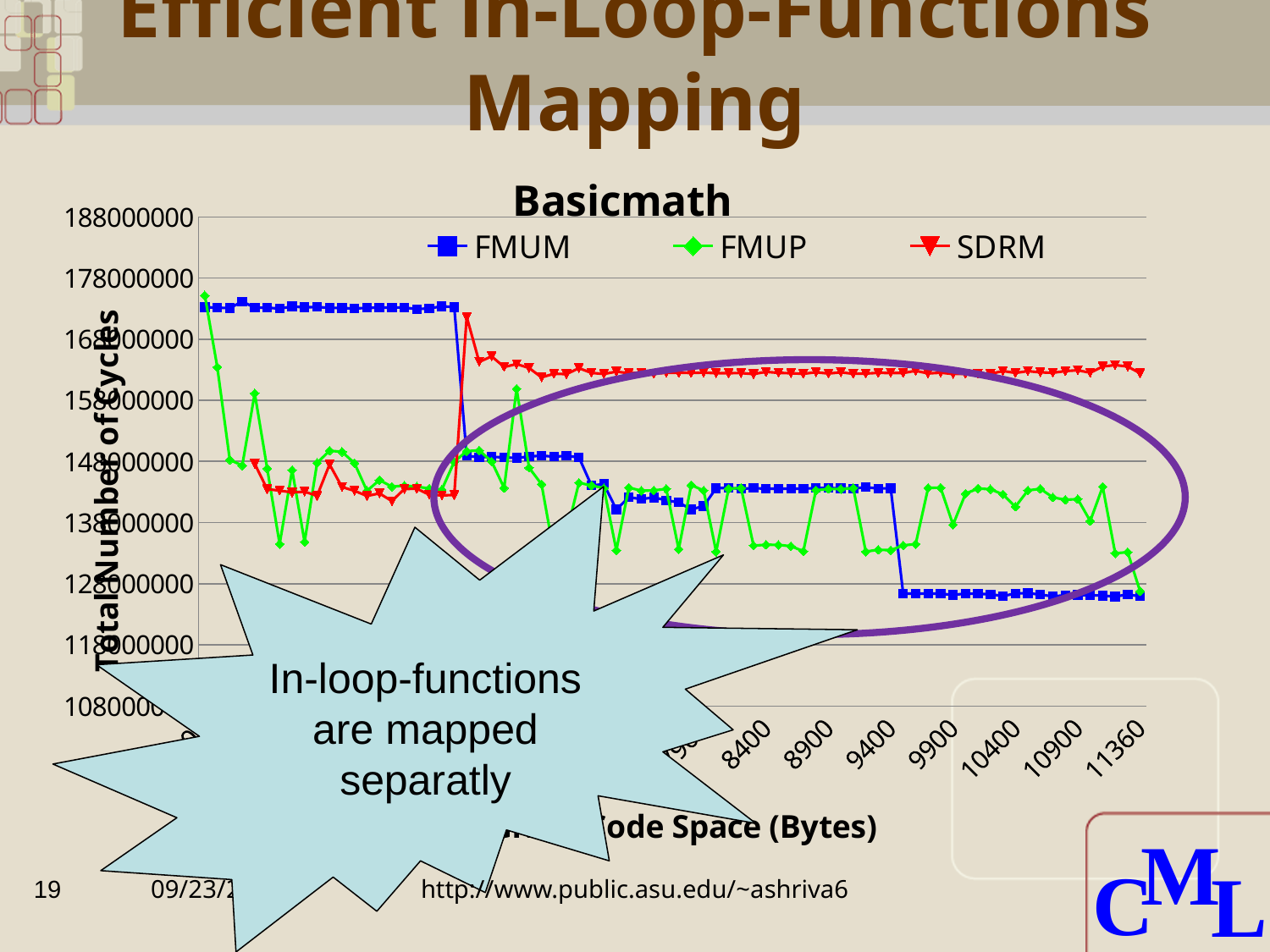
Is the SDRM value at 11360 bytes greater or less than 158000000? greater At 9900 bytes, which series has the larger value, FMUP or FMUM? FMUP Does the FMUM series rise or fall overall as Code Space increases along the x axis? fall Is the FMUP value at 9900 bytes greater or less than 148000000? less What type of chart is shown on the slide? line chart Is the FMUM value at 11360 bytes greater or less than 138000000? less What is the title of the y axis of the Basicmath chart? Total Number of Cycles What are the names of the series in the legend of the Basicmath chart? FMUM, FMUP, SDRM At 11360 bytes, which series has the larger value, SDRM or FMUM? SDRM How many series does the legend of the Basicmath chart list? 3 Does the SDRM series rise or fall overall from the left end to the right end of the x axis? rise At 9900 bytes, which of the three series has the highest value? SDRM